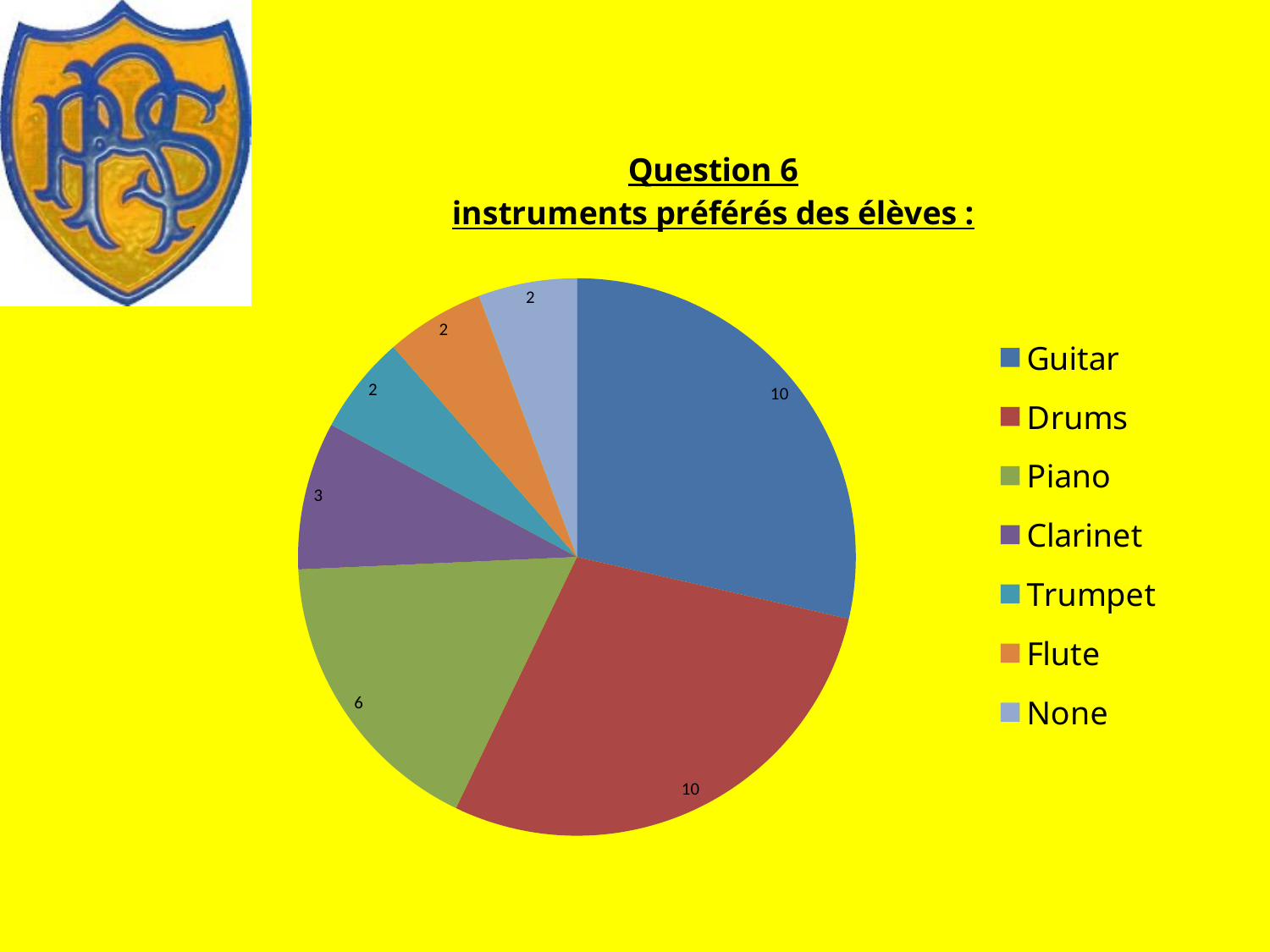
What value is shown for Trumpet in the pie chart? 2 What value is shown for Guitar in the pie chart? 10 What value is shown for Drums in the pie chart? 10 What is the difference between the values for Piano and Clarinet? 3 How many categories does the pie chart show? 7 What is the difference between the values for Guitar and Piano? 4 Which legend entry is shown in light blue at the bottom of the legend? None What kind of chart is shown on the slide? Pie chart Which is larger, the value for Drums or the value for Flute? Drums What value is shown for Piano in the pie chart? 6 Which is larger, the value for Piano or the value for Clarinet? Piano What value is shown for Clarinet in the pie chart? 3